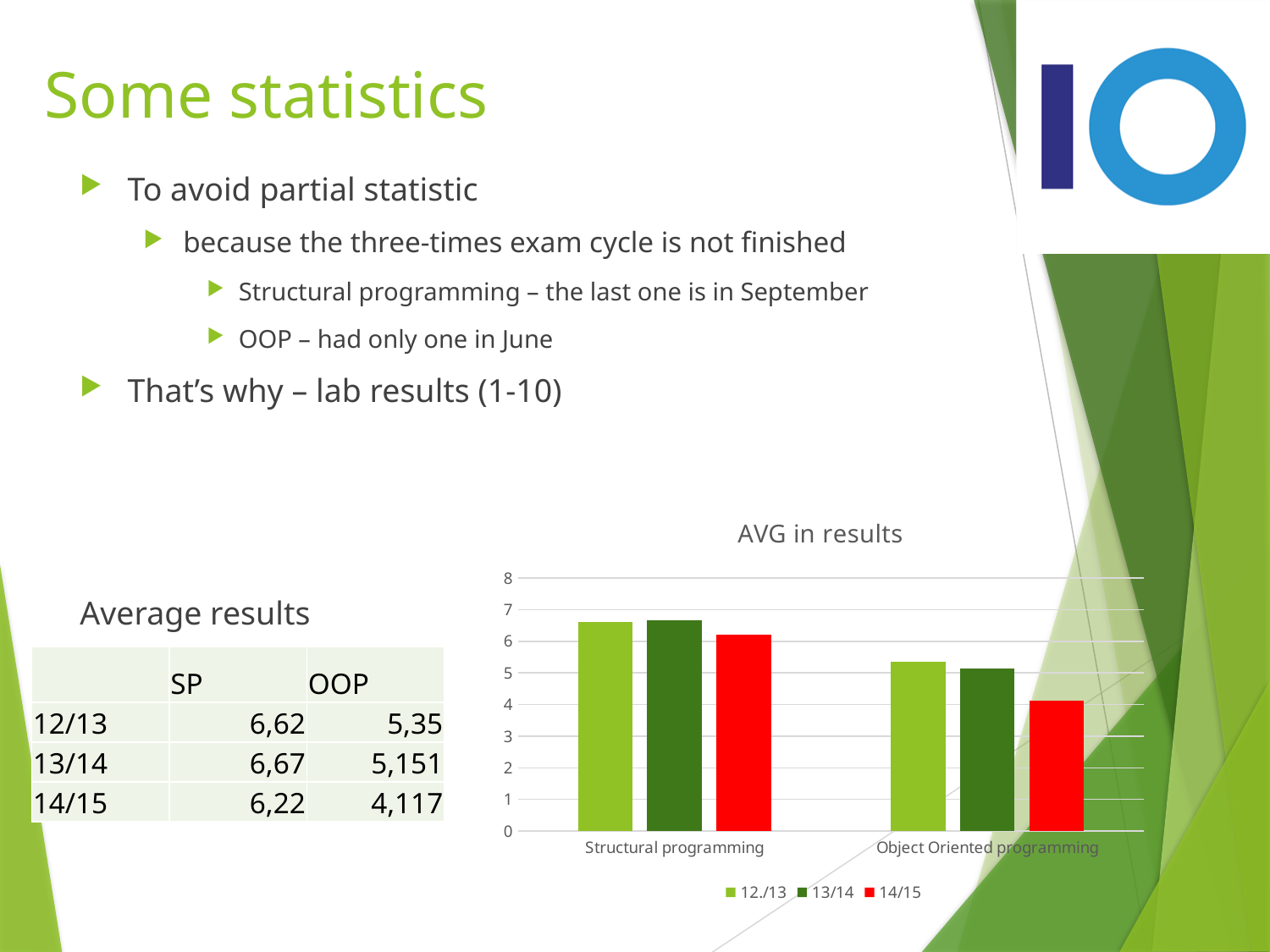
How many categories are shown on the x axis of the 'AVG in results' chart? 2 How many series does the legend of the 'AVG in results' chart list? 3 In the 'AVG in results' chart, is the 12./13 value for Object Oriented programming greater or less than 5? greater In the 'AVG in results' chart, is the 14/15 value for Object Oriented programming greater or less than 5? less In the 'AVG in results' chart, is the 14/15 value for Structural programming greater or less than 6? greater In the 'AVG in results' chart, which category has the lowest bar overall? Object Oriented programming In the 'AVG in results' chart, do the Object Oriented programming bars rise or fall from 12./13 to 14/15? fall What kind of chart is 'AVG in results'? bar chart In the 'AVG in results' chart, which is larger for the 13/14 series: Structural programming or Object Oriented programming? Structural programming In the 'AVG in results' chart, which series has the lowest bar for Object Oriented programming? 14/15 What colour are the 14/15 bars in the 'AVG in results' chart? red According to the 'Average results' table, what is the SP value for 13/14? 6,67